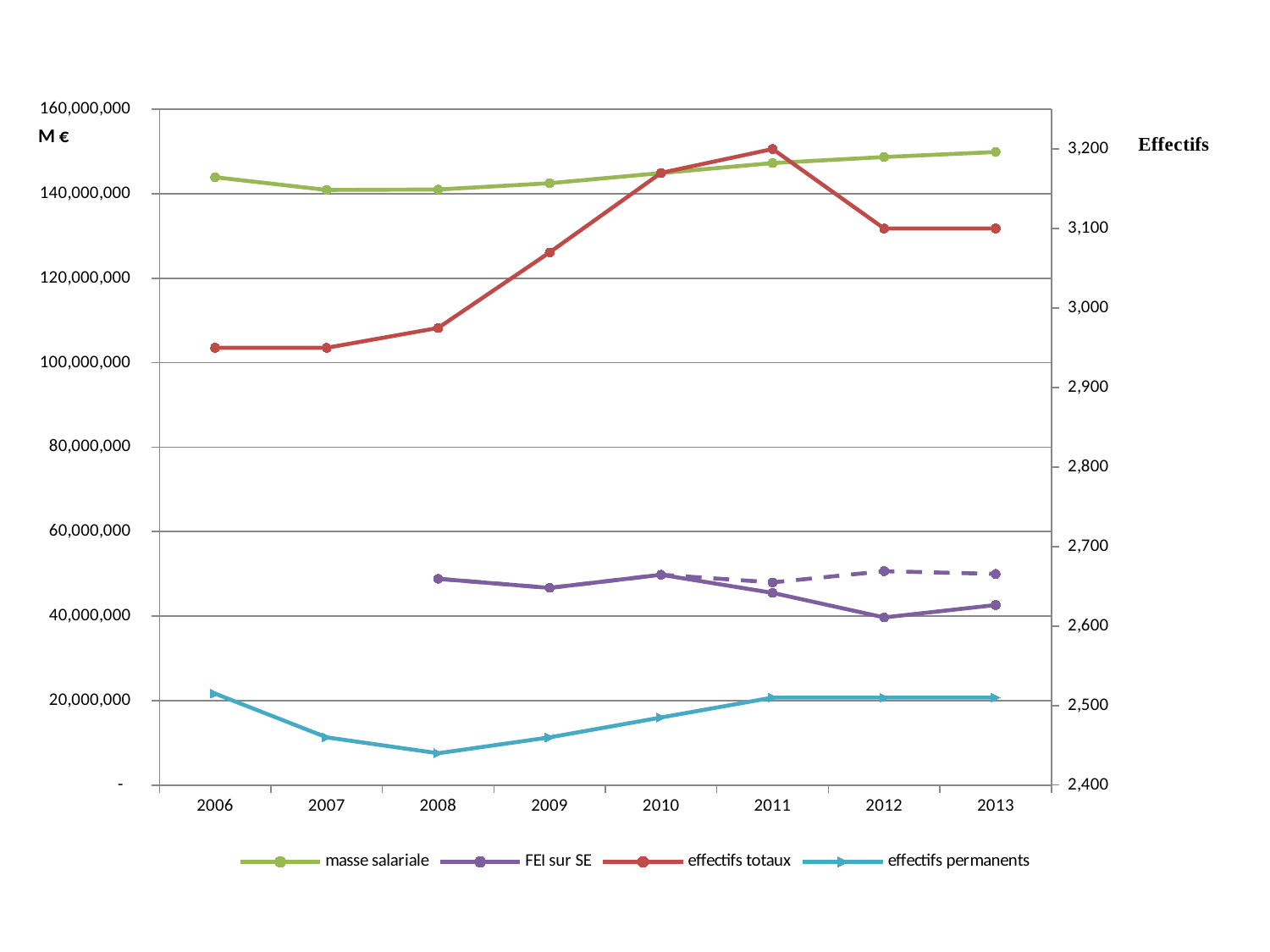
In which year is effectifs totaux highest? 2011 How many series does the legend list? 4 Which is larger, effectifs totaux in 2010 or in 2012? 2010 What is the label of the right-hand vertical axis? Effectifs In which year is effectifs permanents lowest? 2008 Is the value for effectifs totaux in 2011 greater or less than 3,100? greater Is the value for effectifs totaux in 2006 greater or less than 3,000? less In which year is masse salariale highest? 2013 Does effectifs totaux rise or fall from 2007 to 2011? rise How many years are shown on the x axis? 8 Is the value for masse salariale in 2013 greater or less than 140,000,000? greater What kind of chart is shown on the slide? line chart